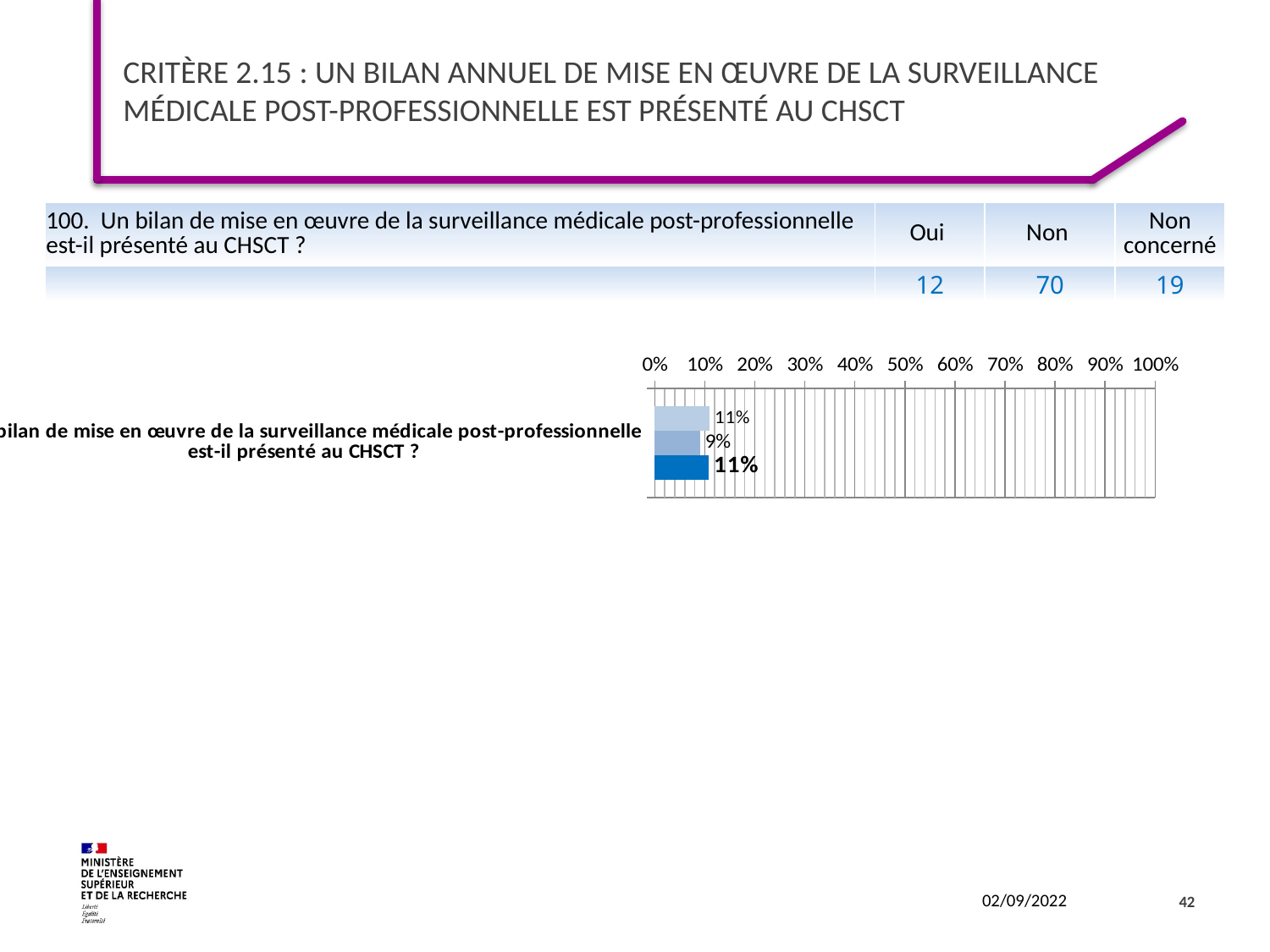
Which is larger, the value of the top bar or the value of the middle bar? the top bar What is the value shown on the top (lightest blue) bar of the chart? 11% What is the difference between the top bar's value and the middle bar's value? 2% What is the interval between tick labels on the chart's horizontal axis? 10% Is the value of the middle bar greater or less than 10%? less Which bar in the chart has the lowest value? the middle bar (9%) How many bars are plotted in the chart? 3 What is the value shown on the middle bar of the chart? 9% What is the maximum value shown on the chart's horizontal axis? 100% Is the value of the bottom bar greater or less than 20%? less What kind of chart is shown on the slide? bar chart What is the value shown on the bottom (dark blue) bar of the chart? 11%